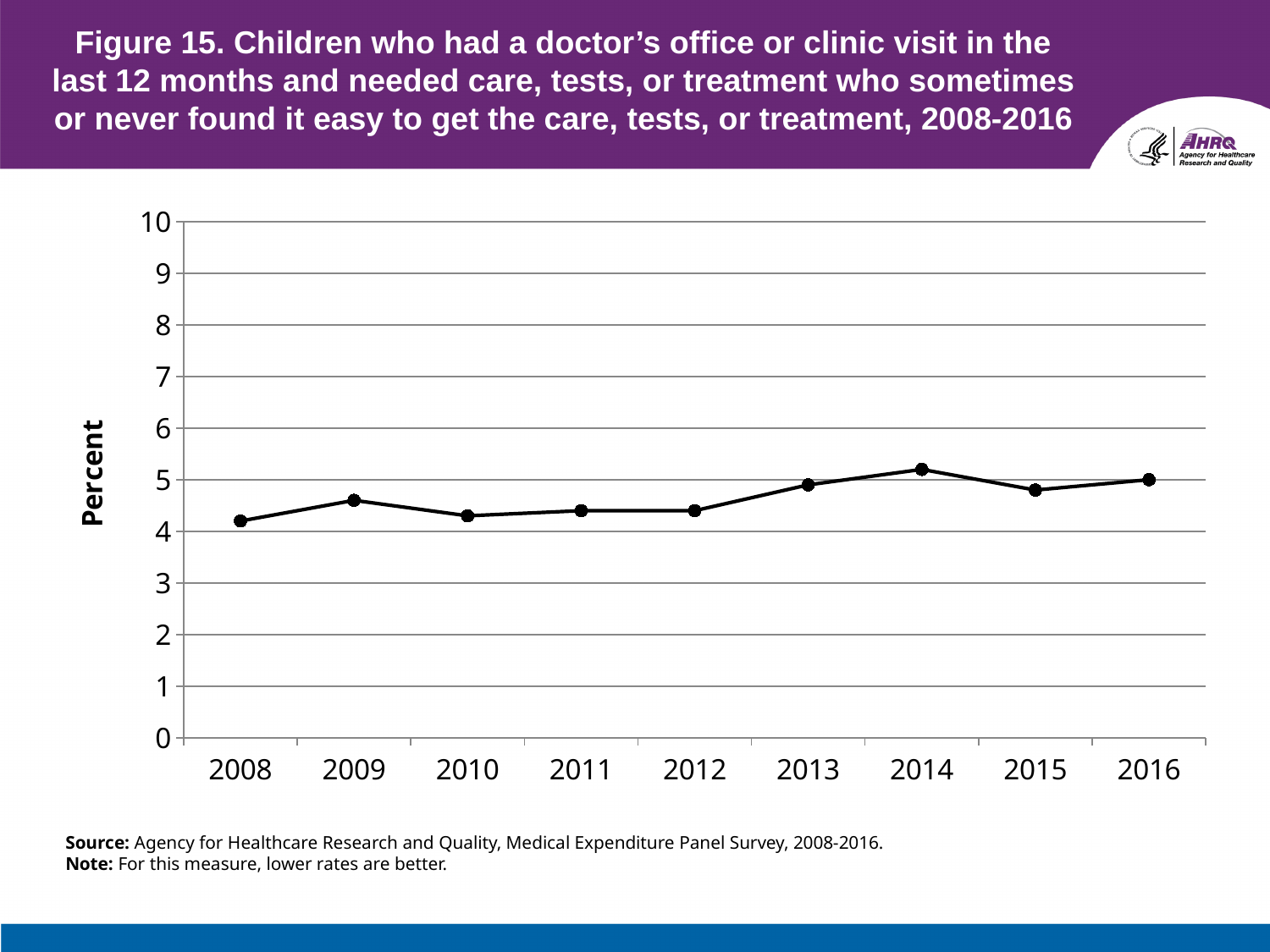
Overall, do the values rise or fall from 2008 to 2016? rise Which is larger, the value for 2009 or the value for 2014? 2014 Which is larger, the value for 2014 or the value for 2008? 2014 Is the value for 2008 greater or less than 4? greater Which year has the highest value on the chart? 2014 Is the value for 2010 greater or less than 5? less Is the value for 2008 greater or less than 5? less What is the maximum value shown on the vertical axis? 10 How many years (data points) are plotted on the chart? 9 What kind of chart is shown on the slide? Line chart What is the label on the vertical axis of the chart? Percent